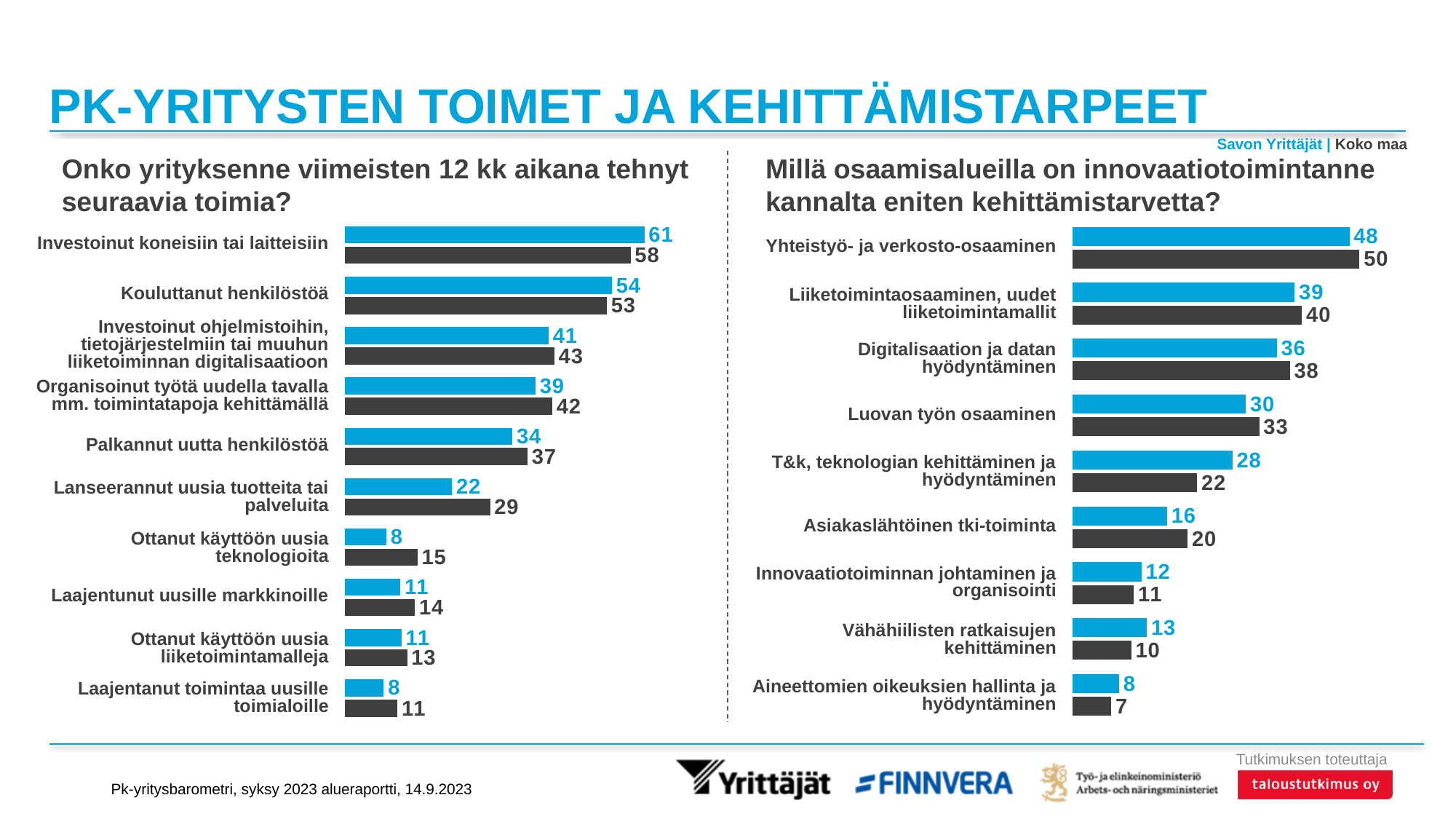
In the right chart (Millä osaamisalueilla on innovaatiotoimintanne kannalta eniten kehittämistarvetta?), which category has the highest Savon Yrittäjät value? Yhteistyö- ja verkosto-osaaminen Which series is shown in blue in the charts on this slide? Savon Yrittäjät In the left chart (Onko yrityksenne viimeisten 12 kk aikana tehnyt seuraavia toimia?), what is the Koko maa value for Lanseerannut uusia tuotteita tai palveluita? 29 In the left chart (Onko yrityksenne viimeisten 12 kk aikana tehnyt seuraavia toimia?), what is the Savon Yrittäjät value for Investoinut koneisiin tai laitteisiin? 61 How many categories does the left chart (Onko yrityksenne viimeisten 12 kk aikana tehnyt seuraavia toimia?) show? 10 How many categories does the right chart (Millä osaamisalueilla on innovaatiotoimintanne kannalta eniten kehittämistarvetta?) show? 9 How many series does the legend list for the charts on this slide? 2 In the right chart (Millä osaamisalueilla on innovaatiotoimintanne kannalta eniten kehittämistarvetta?), which is larger for T&k, teknologian kehittäminen ja hyödyntäminen: the Savon Yrittäjät value or the Koko maa value? Savon Yrittäjät What kind of chart is the left chart (Onko yrityksenne viimeisten 12 kk aikana tehnyt seuraavia toimia?)? Bar chart In the right chart (Millä osaamisalueilla on innovaatiotoimintanne kannalta eniten kehittämistarvetta?), what is the Koko maa value for Yhteistyö- ja verkosto-osaaminen? 50 In the right chart (Millä osaamisalueilla on innovaatiotoimintanne kannalta eniten kehittämistarvetta?), which category has the lowest Koko maa value? Aineettomien oikeuksien hallinta ja hyödyntäminen In the left chart (Onko yrityksenne viimeisten 12 kk aikana tehnyt seuraavia toimia?), what is the difference between the Koko maa and Savon Yrittäjät values for Ottanut käyttöön uusia teknologioita? 7